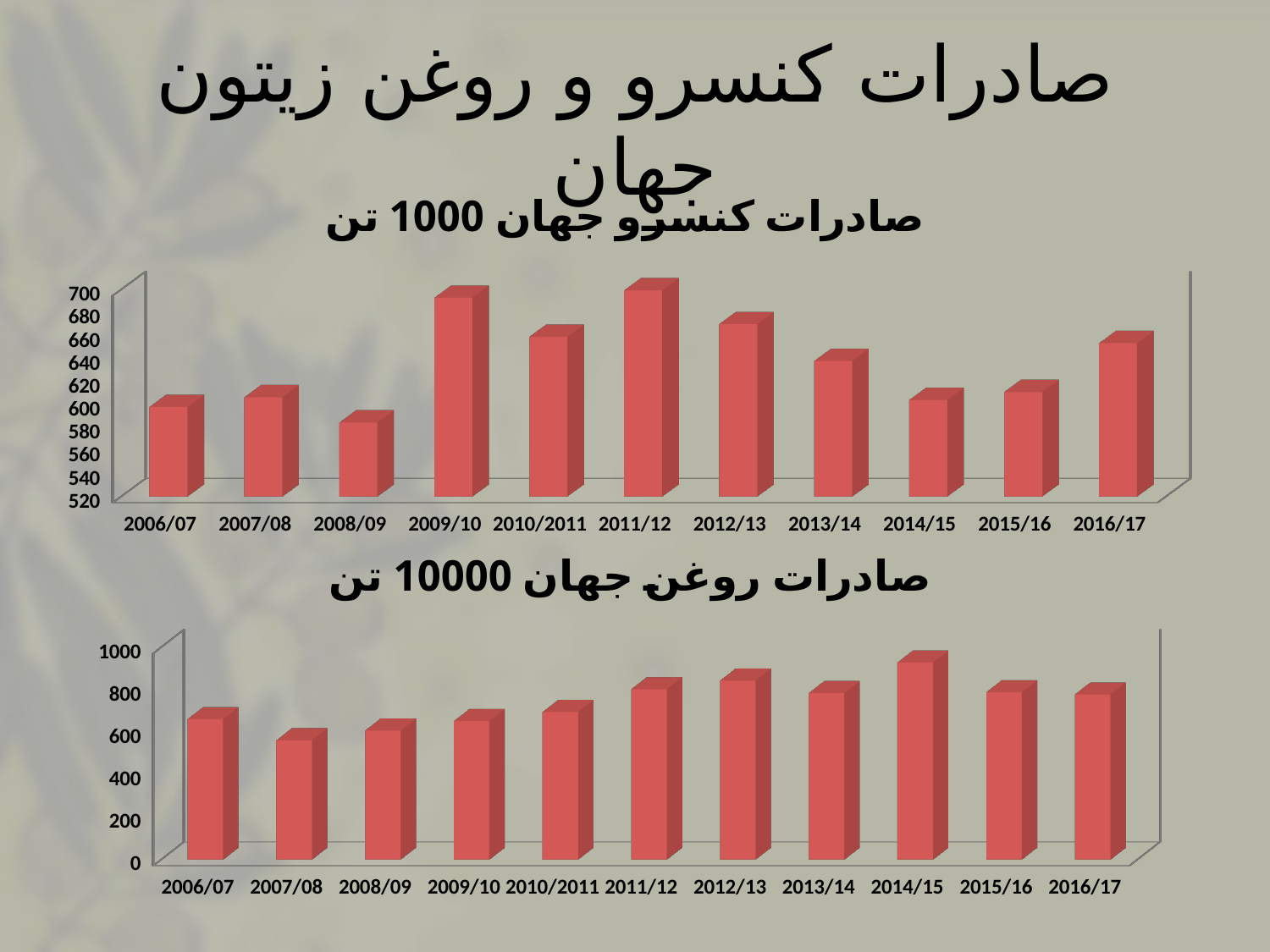
In the bottom chart (صادرات روغن جهان 10000 تن), which is larger, the value for 2014/15 or the value for 2006/07? 2014/15 In the top chart (صادرات کنسرو جهان 1000 تن), which year has the lowest value? 2008/09 In the top chart (صادرات کنسرو جهان 1000 تن), how many years are shown on the x axis? 11 What kind of chart is the top chart titled "صادرات کنسرو جهان 1000 تن"? bar chart In the top chart (صادرات کنسرو جهان 1000 تن), is the value for 2009/10 greater or less than 660? greater In the bottom chart (صادرات روغن جهان 10000 تن), which year has the lowest value? 2007/08 In the bottom chart (صادرات روغن جهان 10000 تن), which year has the highest value? 2014/15 In the bottom chart (صادرات روغن جهان 10000 تن), is the value for 2014/15 greater or less than 800? greater In the bottom chart (صادرات روغن جهان 10000 تن), is the value for 2010/2011 greater or less than 800? less In the top chart (صادرات کنسرو جهان 1000 تن), which is larger, the value for 2009/10 or the value for 2008/09? 2009/10